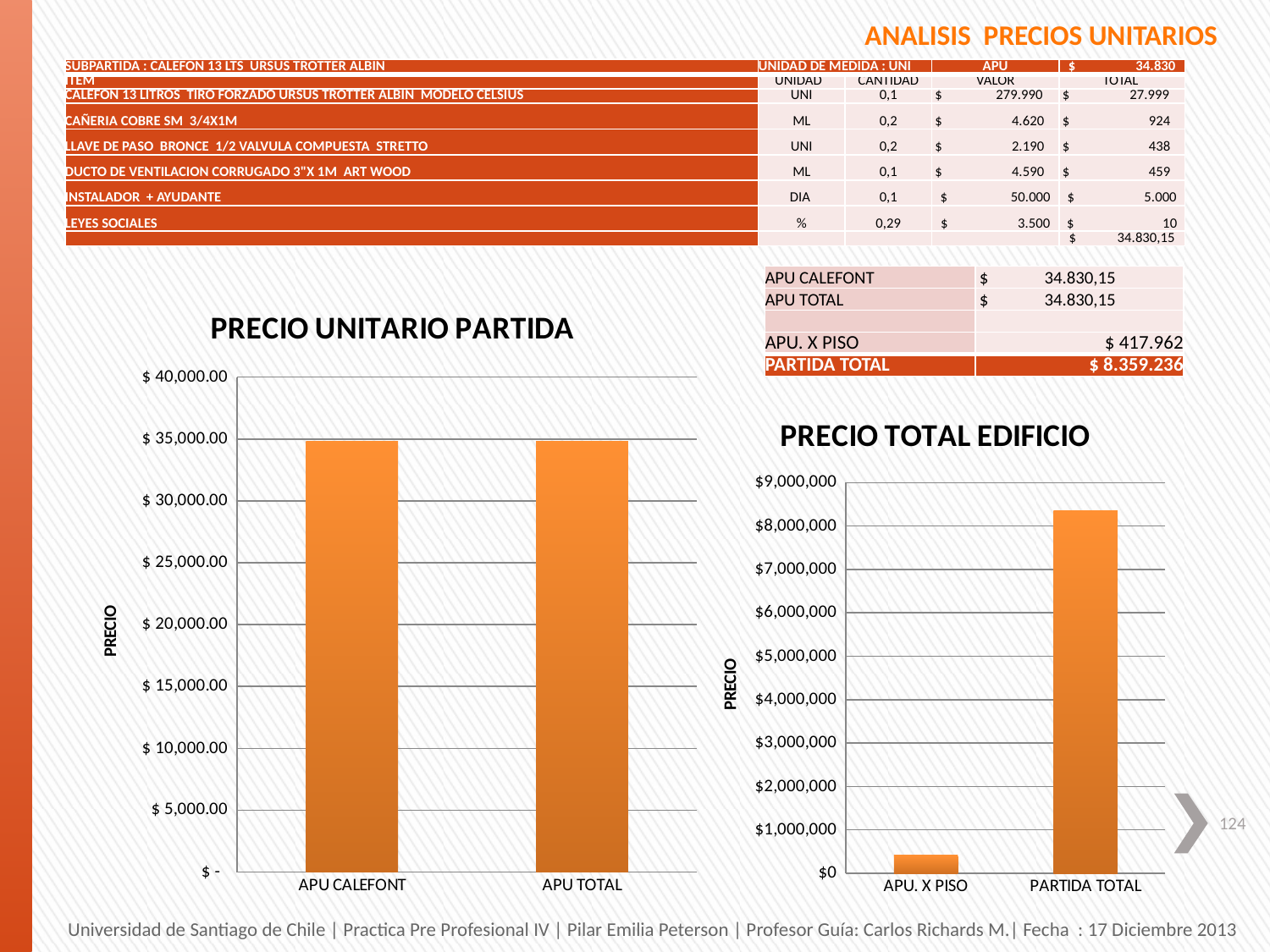
In the 'PRECIO TOTAL EDIFICIO' chart, which category has the lowest value? APU. X PISO What type of chart is the 'PRECIO TOTAL EDIFICIO' chart? bar chart In the 'PRECIO TOTAL EDIFICIO' chart, which category has the highest value? PARTIDA TOTAL In the 'PRECIO UNITARIO PARTIDA' chart, is the value for APU CALEFONT greater or less than $30,000.00? greater In the 'PRECIO TOTAL EDIFICIO' chart, is the value for PARTIDA TOTAL greater or less than $8,000,000? greater In the 'PRECIO TOTAL EDIFICIO' chart, is the value for APU. X PISO greater or less than $1,000,000? less How many bars are plotted in the 'PRECIO TOTAL EDIFICIO' chart? 2 How many categories are shown on the x axis of the 'PRECIO UNITARIO PARTIDA' chart? 2 In the 'PRECIO TOTAL EDIFICIO' chart, which is larger, APU. X PISO or PARTIDA TOTAL? PARTIDA TOTAL What type of chart is the 'PRECIO UNITARIO PARTIDA' chart? bar chart What is the y-axis label of the 'PRECIO UNITARIO PARTIDA' chart? PRECIO